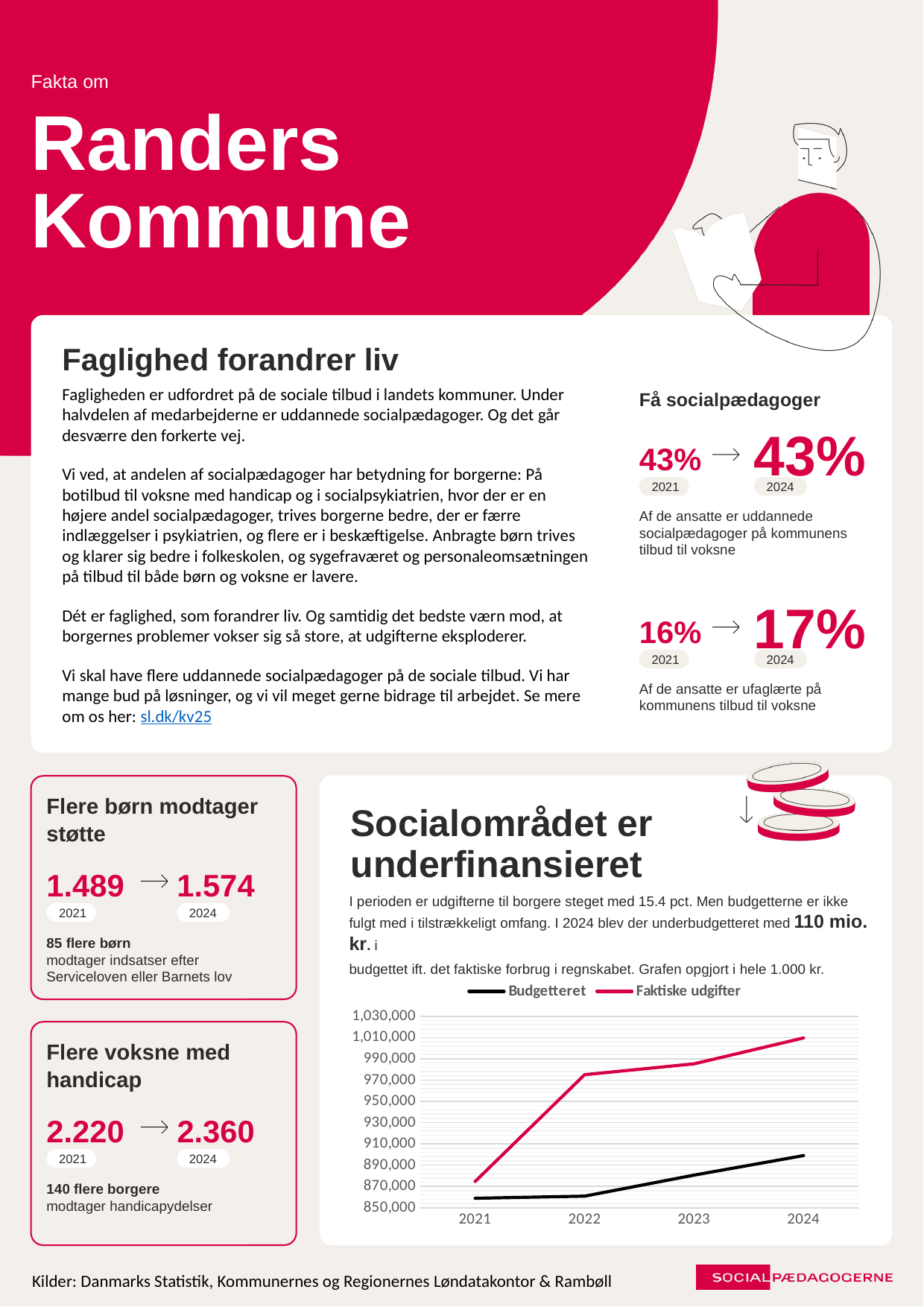
In the "Socialområdet er underfinansieret" chart, what colour is the Faktiske udgifter line? red In the "Socialområdet er underfinansieret" chart, which series has the higher value in 2024, Budgetteret or Faktiske udgifter? Faktiske udgifter In the "Socialområdet er underfinansieret" chart, is the value for Budgetteret in 2024 greater or less than 910,000? less How many series does the legend of the "Socialområdet er underfinansieret" chart list? 2 In the "Socialområdet er underfinansieret" chart, is the value for Faktiske udgifter in 2021 greater or less than 890,000? less In the "Socialområdet er underfinansieret" chart, is the value for Budgetteret in 2021 greater or less than 870,000? less In the "Socialområdet er underfinansieret" chart, do the Faktiske udgifter values rise or fall from 2021 to 2024? rise What kind of chart is shown under the heading "Socialområdet er underfinansieret"? line chart How many years are plotted along the x axis of the "Socialområdet er underfinansieret" chart? 4